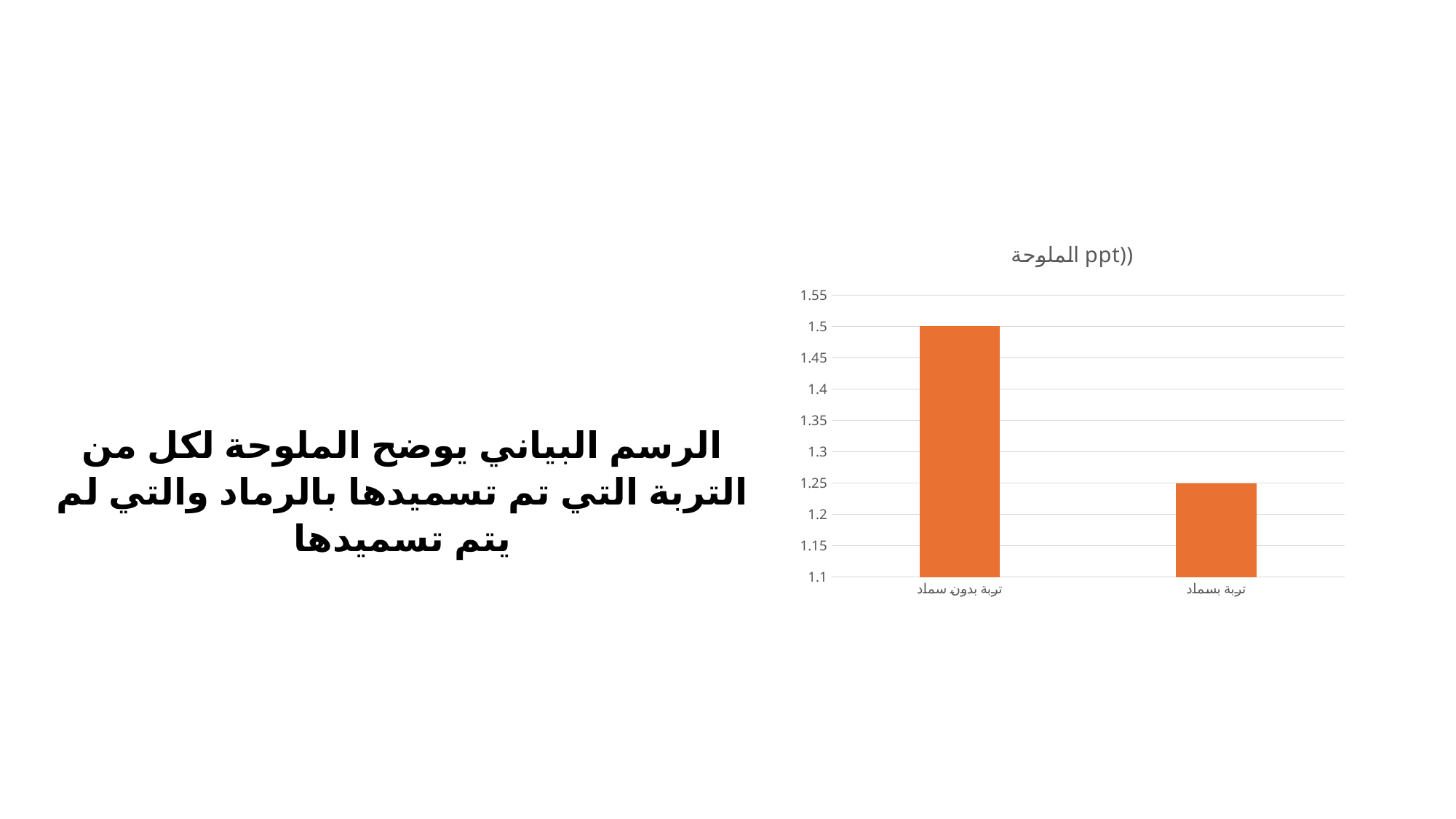
What is the salinity value for تربة بسماد? 1.25 What is the salinity value for تربة بدون سماد? 1.5 What is the title of the chart? الملوحة (ppt) Which has a larger salinity value, تربة بسماد or تربة بدون سماد? تربة بدون سماد Which category has the lowest salinity? تربة بسماد Is the value for تربة بدون سماد greater or less than 1.3? greater How many categories are plotted in the chart? 2 What is the difference in salinity between تربة بدون سماد and تربة بسماد? 0.25 Is the value for تربة بسماد greater or less than 1.4? less Which category has the highest salinity? تربة بدون سماد What type of chart is shown on the slide? bar chart What colour are the bars in the chart? orange